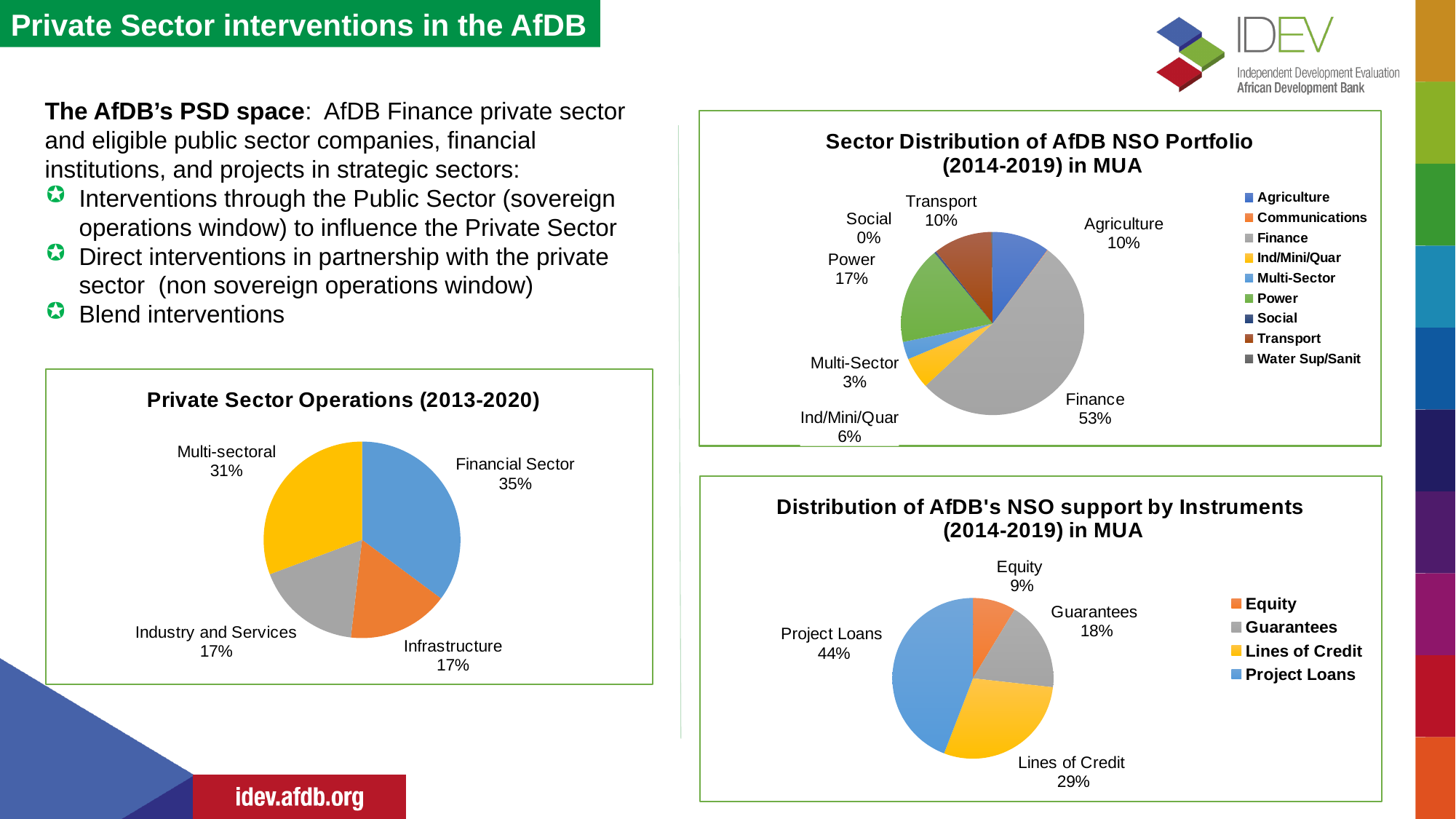
In the 'Distribution of AfDB's NSO support by Instruments (2014-2019) in MUA' chart, which instrument has the smallest share? Equity In the 'Private Sector Operations (2013-2020)' chart, what share does the Financial Sector have? 35% In the 'Private Sector Operations (2013-2020)' chart, what is the difference in percentage points between Financial Sector and Multi-sectoral? 4 In the 'Private Sector Operations (2013-2020)' chart, which category has the largest share? Financial Sector How many entries does the legend of the 'Sector Distribution of AfDB NSO Portfolio (2014-2019) in MUA' chart list? 9 In the 'Distribution of AfDB's NSO support by Instruments (2014-2019) in MUA' chart, what is the difference in percentage points between Lines of Credit and Guarantees? 11 In the 'Sector Distribution of AfDB NSO Portfolio (2014-2019) in MUA' chart, what share does Finance have? 53% In the 'Distribution of AfDB's NSO support by Instruments (2014-2019) in MUA' chart, what share do Project Loans have? 44% In the 'Sector Distribution of AfDB NSO Portfolio (2014-2019) in MUA' chart, which sector has the largest share? Finance In the 'Sector Distribution of AfDB NSO Portfolio (2014-2019) in MUA' chart, which is larger, Multi-Sector or Ind/Mini/Quar? Ind/Mini/Quar What kind of chart is 'Private Sector Operations (2013-2020)'? Pie chart In the 'Sector Distribution of AfDB NSO Portfolio (2014-2019) in MUA' chart, what share does Power have? 17%